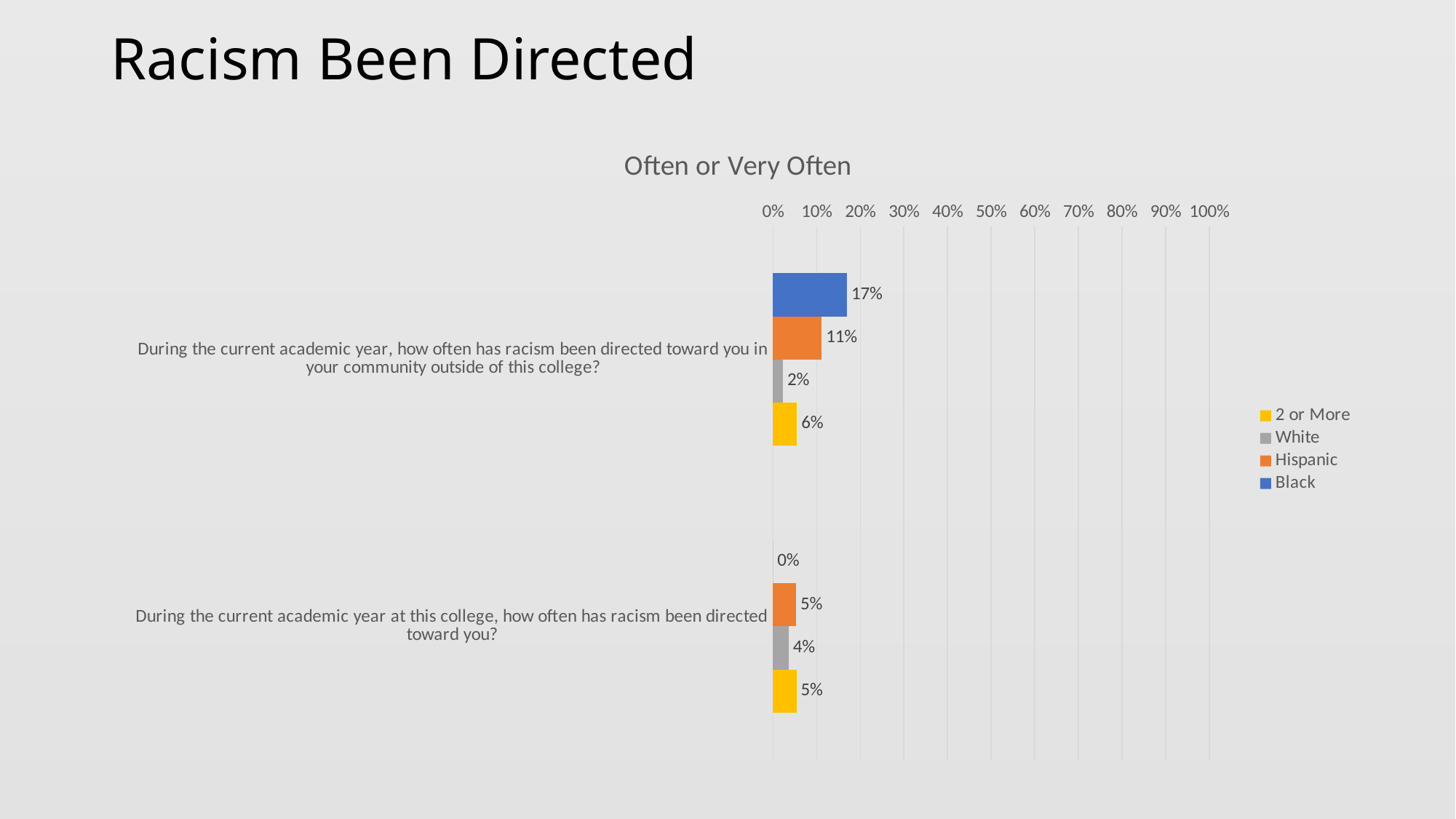
What is the difference between the Black and Hispanic values for the question about racism directed toward you in your community outside of this college? 6% What colour represents the Hispanic series in the chart? Orange What is the value for White students for the question about racism directed toward you in your community outside of this college? 2% What is the title of the chart? Often or Very Often What is the value for Black students for the question about racism directed toward you in your community outside of this college? 17% How many series does the legend list? 4 What kind of chart is shown on the slide? Bar chart Which group has the highest value for the question about racism directed toward you in your community outside of this college? Black What is the value for Black students for the question about racism directed toward you at this college? 0% What is the value for Hispanic students for the question about racism directed toward you at this college? 5% Which is larger for the question about racism directed toward you at this college: the value for White or the value for 2 or More? 2 or More Which group has the lowest value for the question about racism directed toward you at this college? Black